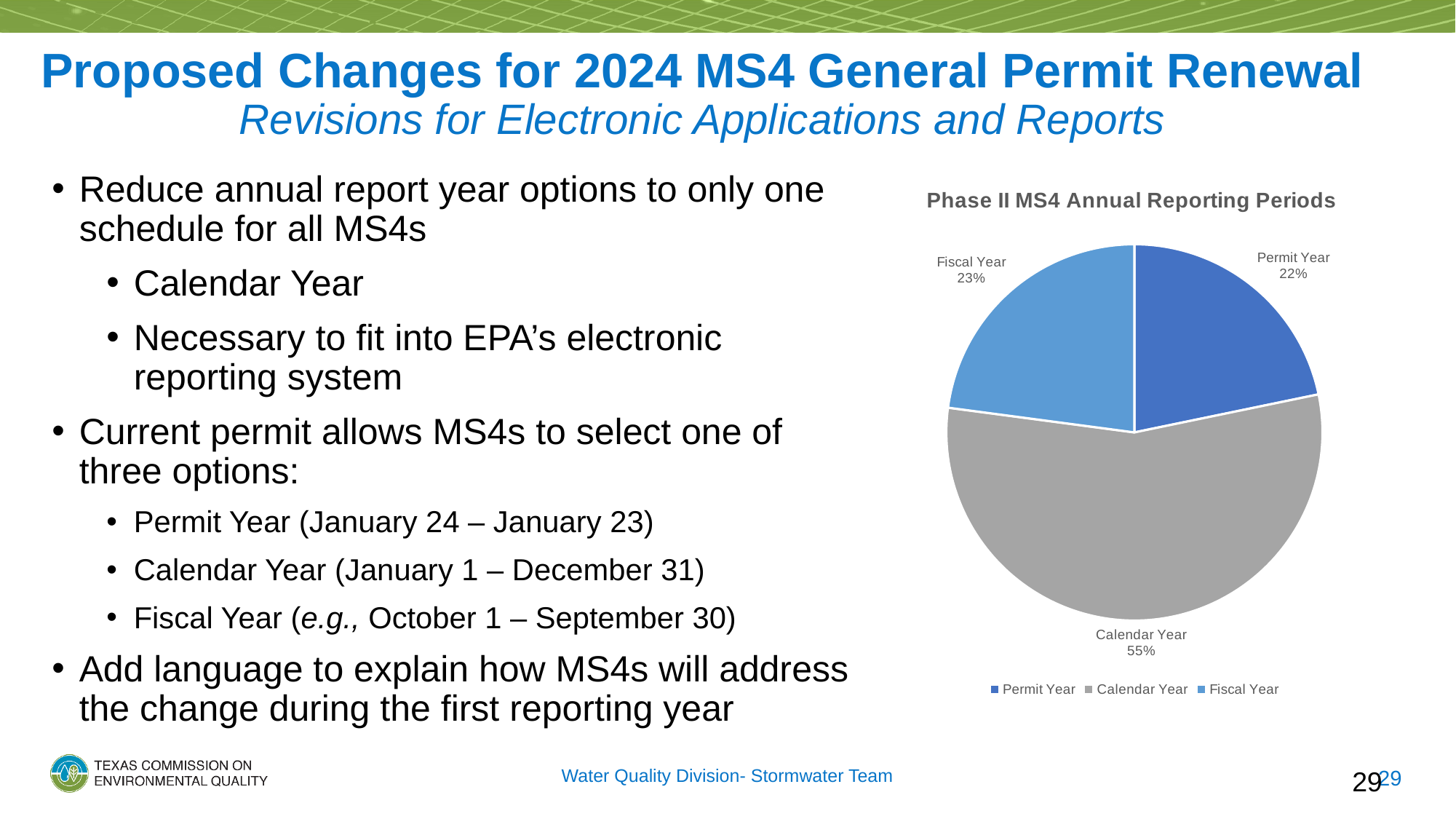
How many entries does the legend list? 3 What share of the pie does Permit Year represent? 22% What colour is the Calendar Year slice? Gray What type of chart is shown on the slide? Pie chart Which reporting period has the smallest share of the pie? Permit Year Which reporting period has the largest share of the pie? Calendar Year What is the difference in percentage points between the Calendar Year and Fiscal Year shares? 32 Which is larger, the Fiscal Year share or the Permit Year share? Fiscal Year What is the title of the chart? Phase II MS4 Annual Reporting Periods How many slices does the pie chart have? 3 What share of the pie does Calendar Year represent? 55% What share of the pie does Fiscal Year represent? 23%